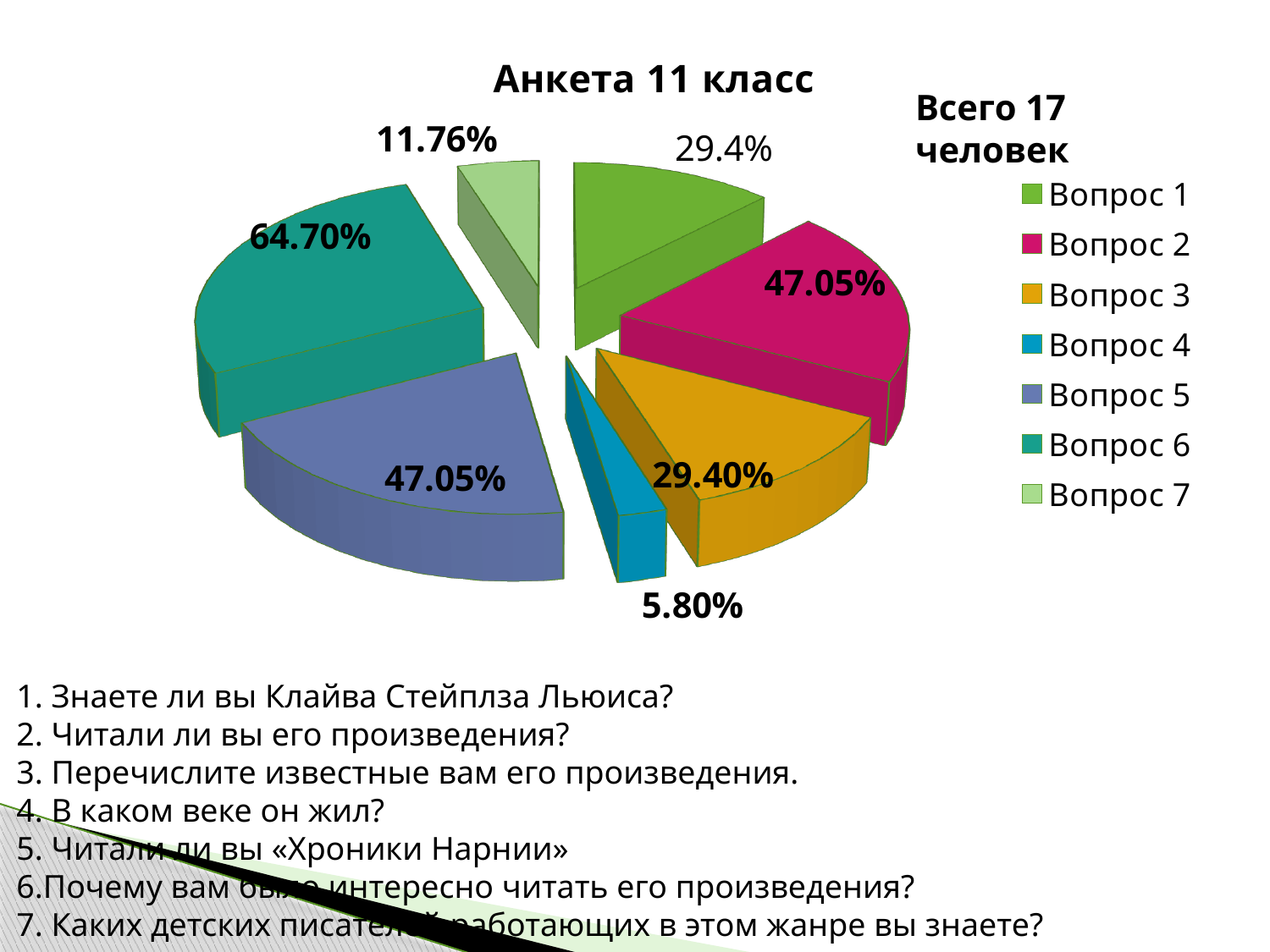
What value is labelled for Вопрос 6? 64.70% How many entries does the legend list? 7 What value is labelled for Вопрос 4? 5.80% Which is larger, the value for Вопрос 6 or the value for Вопрос 1? Вопрос 6 What value is labelled for Вопрос 7? 11.76% What is the title of the chart? Анкета 11 класс Which legend entry has the smallest slice? Вопрос 4 What is the difference between the labelled values for Вопрос 6 and Вопрос 5? 17.65% Which legend entry has the largest slice? Вопрос 6 What kind of chart is shown on the slide? pie chart How many slices does the pie chart have? 7 What value is labelled for Вопрос 2? 47.05%